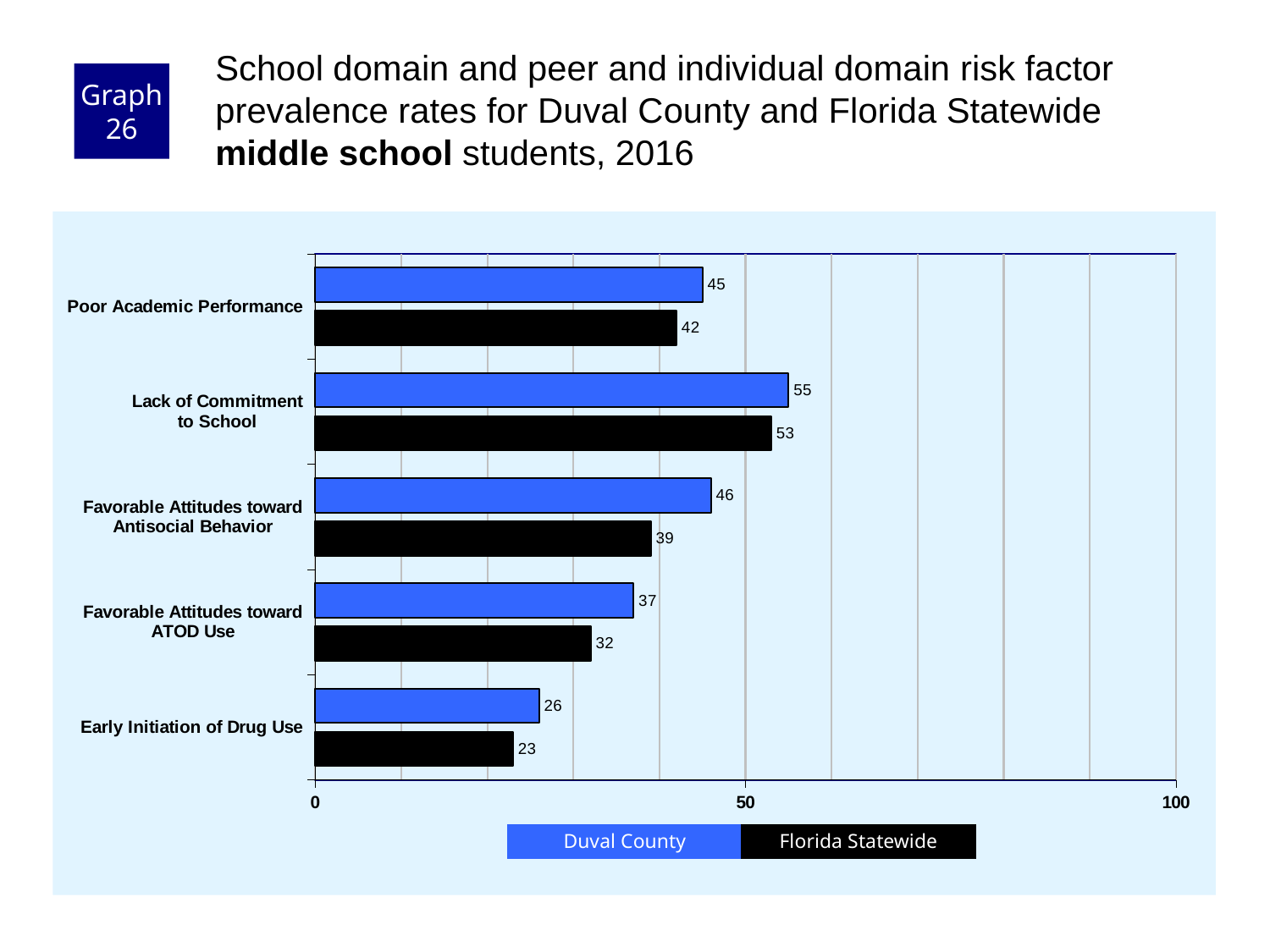
What kind of chart is shown on the slide? Bar chart What is the Duval County value for Early Initiation of Drug Use? 26 Which risk factor has the lowest Florida Statewide value? Early Initiation of Drug Use What is the difference between the Duval County and Florida Statewide values for Favorable Attitudes toward Antisocial Behavior? 7 How many risk factor categories are shown in the chart? 5 Which risk factor has the highest Duval County value? Lack of Commitment to School How many series does the legend list? 2 What is the Florida Statewide value for Favorable Attitudes toward Antisocial Behavior? 39 What is the difference between the Duval County and Florida Statewide values for Favorable Attitudes toward ATOD Use? 5 Which is larger for Poor Academic Performance: the Duval County value or the Florida Statewide value? Duval County What is the Duval County value for Lack of Commitment to School? 55 Is the Florida Statewide value for Lack of Commitment to School greater or less than 50? greater